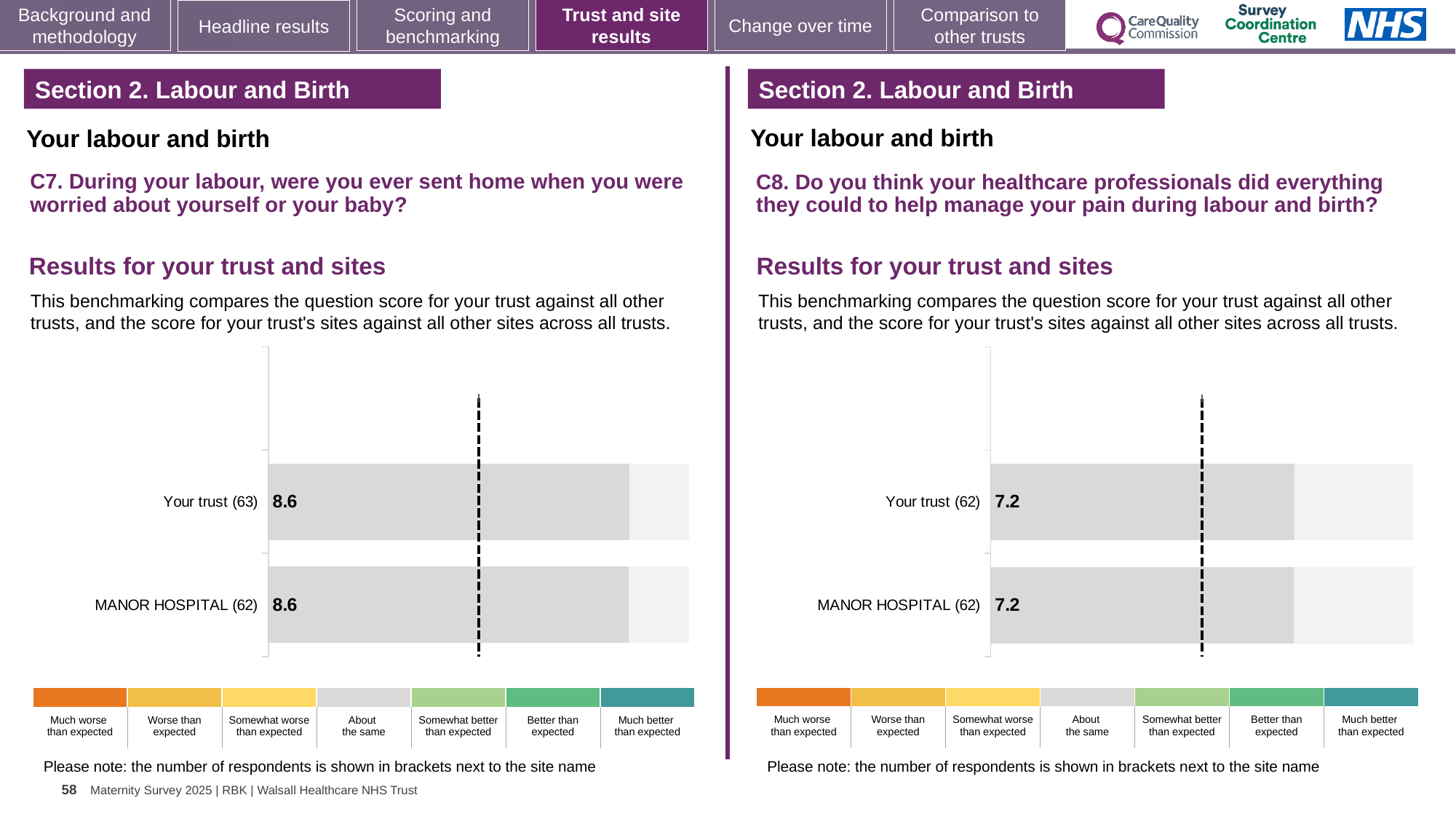
In the C8 chart on the right, what is the score for MANOR HOSPITAL? 7.2 How many categories does the colour legend below the C8 chart on the right list? 7 In the C7 chart on the left, what is the score for MANOR HOSPITAL? 8.6 In the C8 chart on the right, what is the score for Your trust? 7.2 In the C7 chart on the left, what is the difference between the Your trust score and the MANOR HOSPITAL score? 0.0 What kind of chart is used in the C7 chart on the left? Bar chart In the C8 chart on the right, what is the difference between the Your trust score and the MANOR HOSPITAL score? 0.0 In the C7 chart on the left, what is the score for Your trust? 8.6 How many bars are plotted in the C8 chart on the right? 2 How many bars are plotted in the C7 chart on the left? 2 In the C8 chart on the right, how many respondents are shown in brackets for MANOR HOSPITAL? 62 In the C7 chart on the left, how many respondents are shown in brackets for Your trust? 63